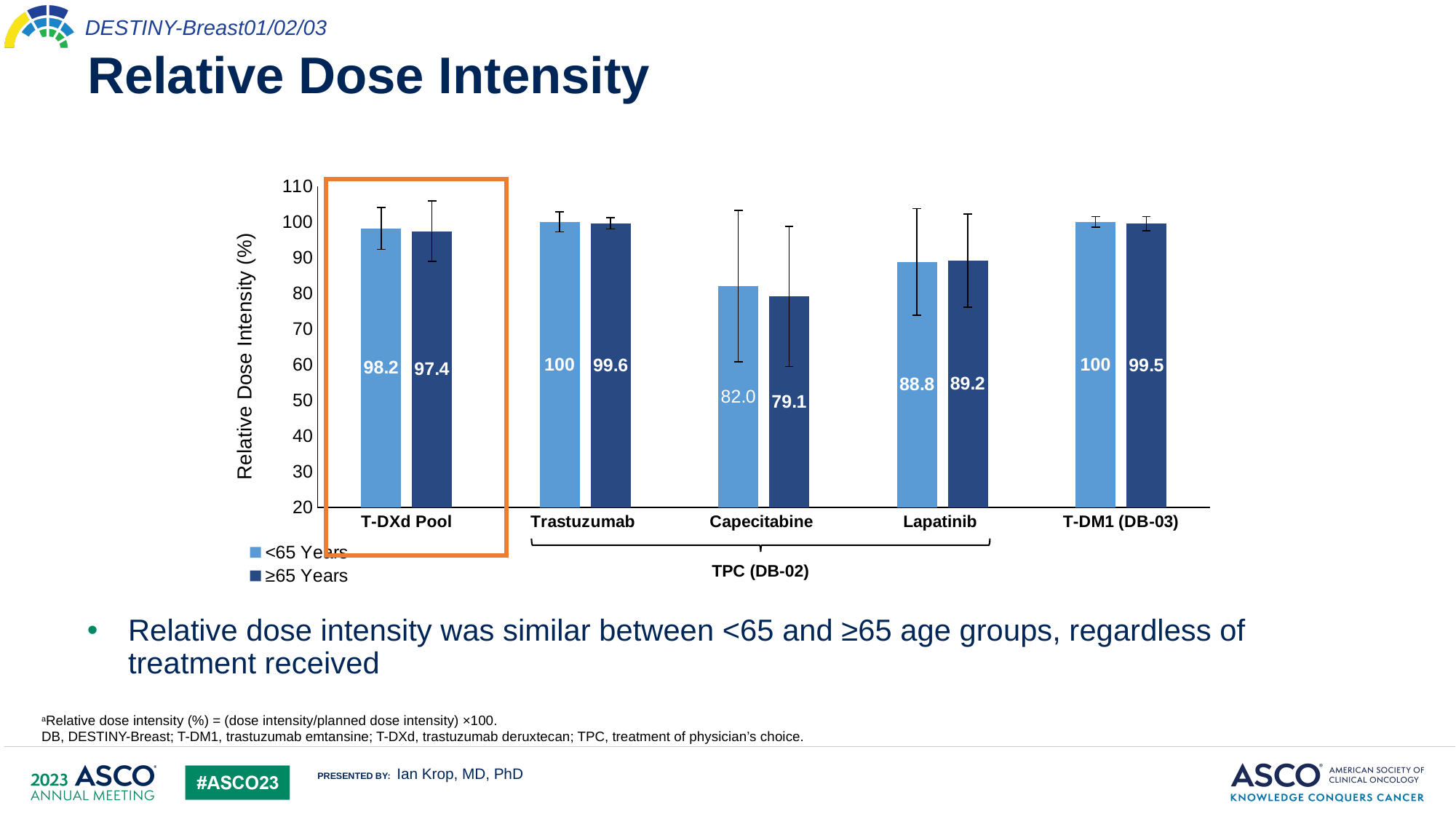
What is the relative dose intensity for the <65 Years group receiving T-DM1 (DB-03)? 100 What is the relative dose intensity for the ≥65 Years group receiving Capecitabine? 79.1 How many series does the legend list? 2 How many treatment categories are shown on the x axis? 5 What is the difference between the <65 Years and ≥65 Years relative dose intensity values for Capecitabine? 2.9 Which treatments are grouped under the TPC (DB-02) bracket? Trastuzumab, Capecitabine, Lapatinib Which treatment has the lowest relative dose intensity for the ≥65 Years group? Capecitabine Which is larger for Lapatinib: the <65 Years value or the ≥65 Years value? ≥65 Years What is the relative dose intensity for the ≥65 Years group receiving Lapatinib? 89.2 Is the relative dose intensity for the <65 Years group receiving Capecitabine greater or less than 90? less What kind of chart is shown on the slide? Bar chart What is the relative dose intensity for the <65 Years group in the T-DXd Pool? 98.2